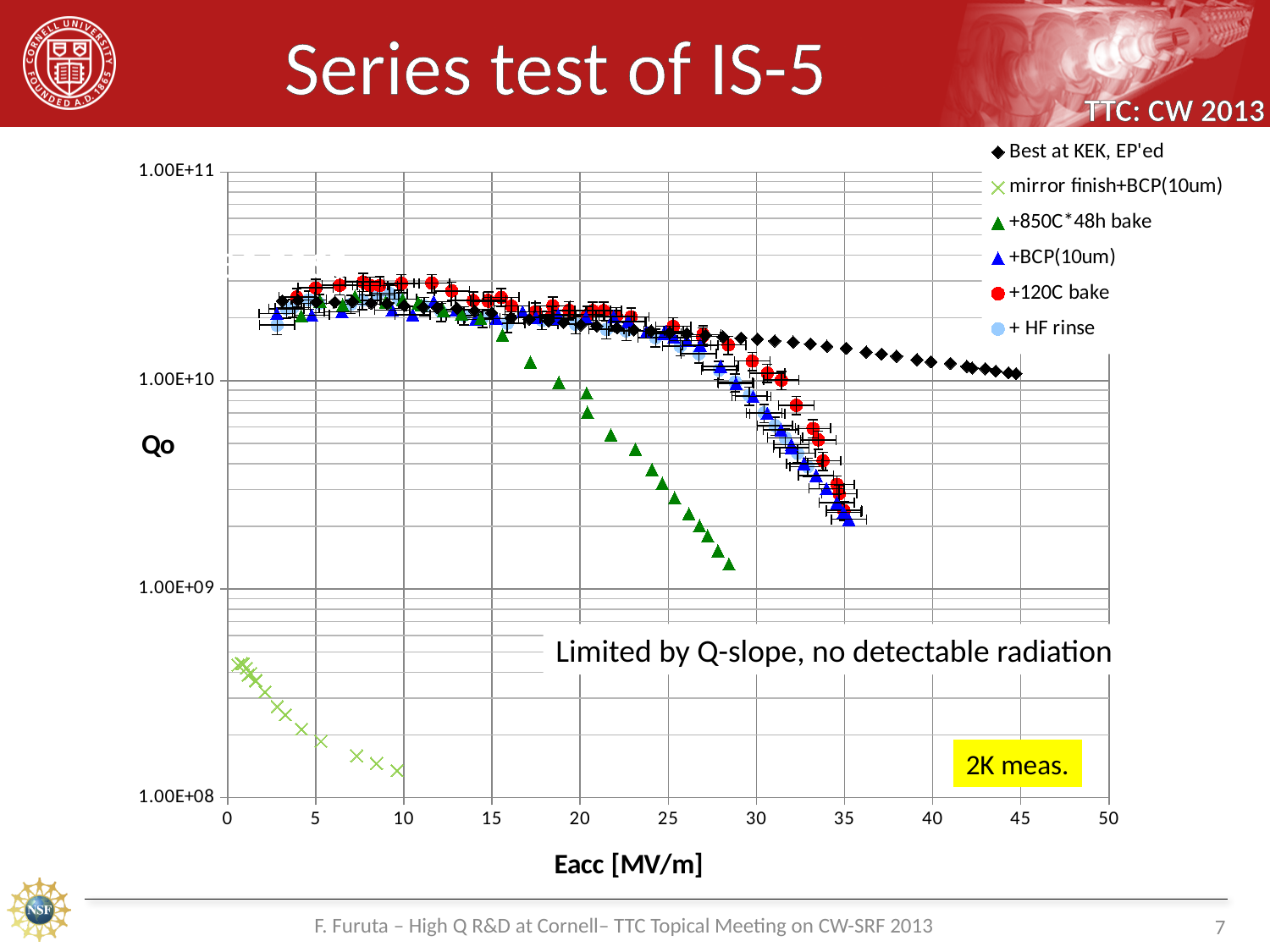
What kind of chart is shown on the slide? Scatter chart Is the Qo value for the +850C*48h bake series at its highest Eacc (about 28 MV/m) greater or less than 1.00E+10? less Is the Qo value for the mirror finish+BCP(10um) series at Eacc of about 1 MV/m greater or less than 1.00E+09? less What is the highest Eacc value shown on the x axis of the chart? 50 Is the Qo value for the +850C*48h bake series at its highest Eacc (about 28 MV/m) greater or less than 1.00E+09? greater Which series in the chart has the lowest Qo values? mirror finish+BCP(10um) How many series does the chart legend list? 6 Does the Qo of the +850C*48h bake series rise or fall as Eacc increases beyond 15 MV/m? Fall What is the label of the y axis of the chart? Qo Which series in the chart extends to the highest Eacc values? Best at KEK, EP'ed What is the label of the x axis of the chart? Eacc [MV/m] Does the Qo of the mirror finish+BCP(10um) series rise or fall as Eacc increases? Fall